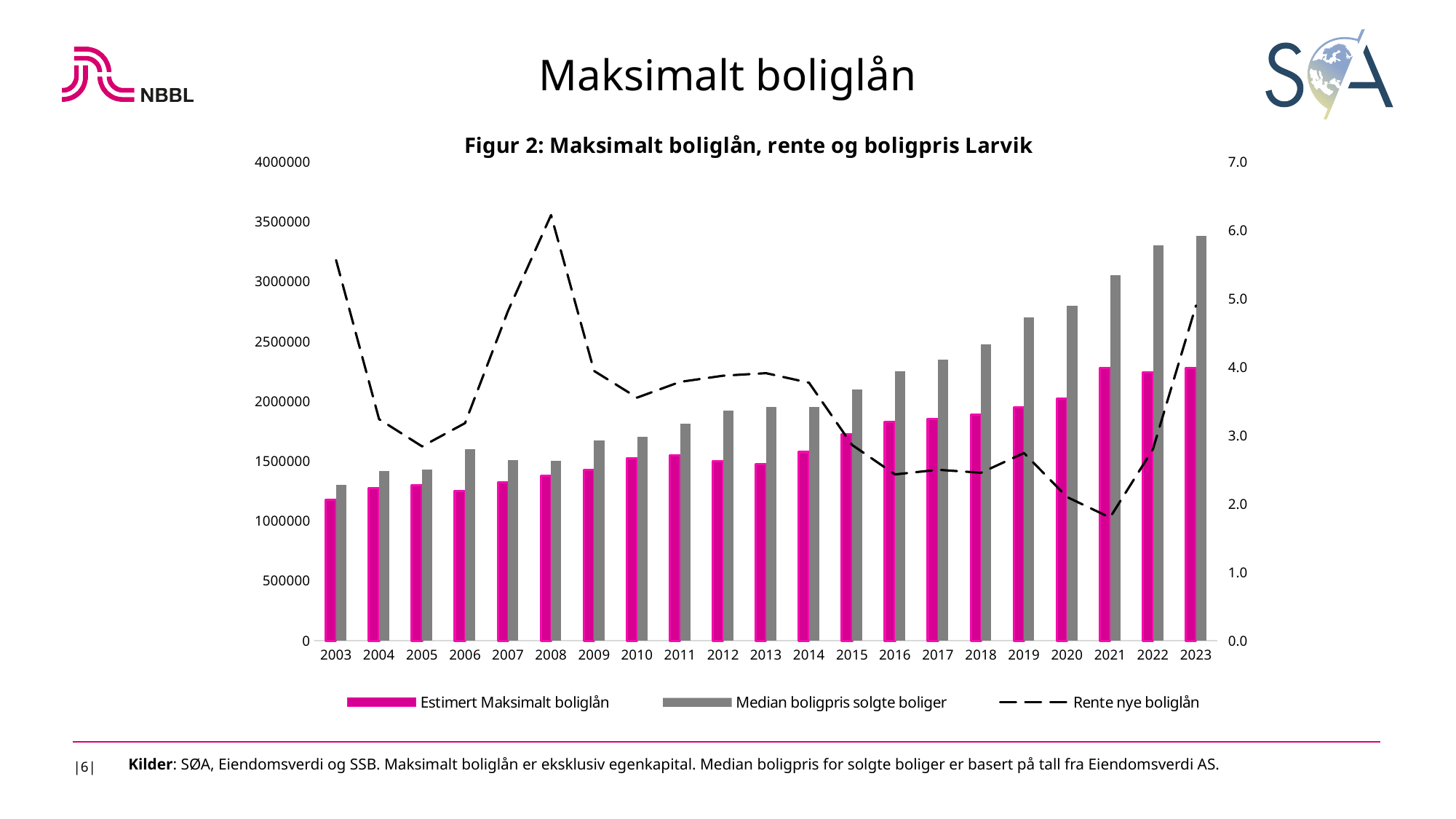
Is the value for Median boligpris solgte boliger in 2023 greater or less than 3000000? greater Which year has the lowest value for Median boligpris solgte boliger? 2003 How many years are shown on the x axis? 21 In which year does Rente nye boliglån reach its lowest point? 2021 Is the value for Rente nye boliglån in 2021 greater or less than 2.0? less In which year does Rente nye boliglån reach its highest point? 2008 Which year has the highest value for Median boligpris solgte boliger? 2023 What kind of chart is this? Combined bar and line chart How many series does the legend list? 3 In 2015, which is larger: Estimert Maksimalt boliglån or Median boligpris solgte boliger? Median boligpris solgte boliger Which year has the lowest value for Estimert Maksimalt boliglån? 2003 What is the title of the chart? Figur 2: Maksimalt boliglån, rente og boligpris Larvik